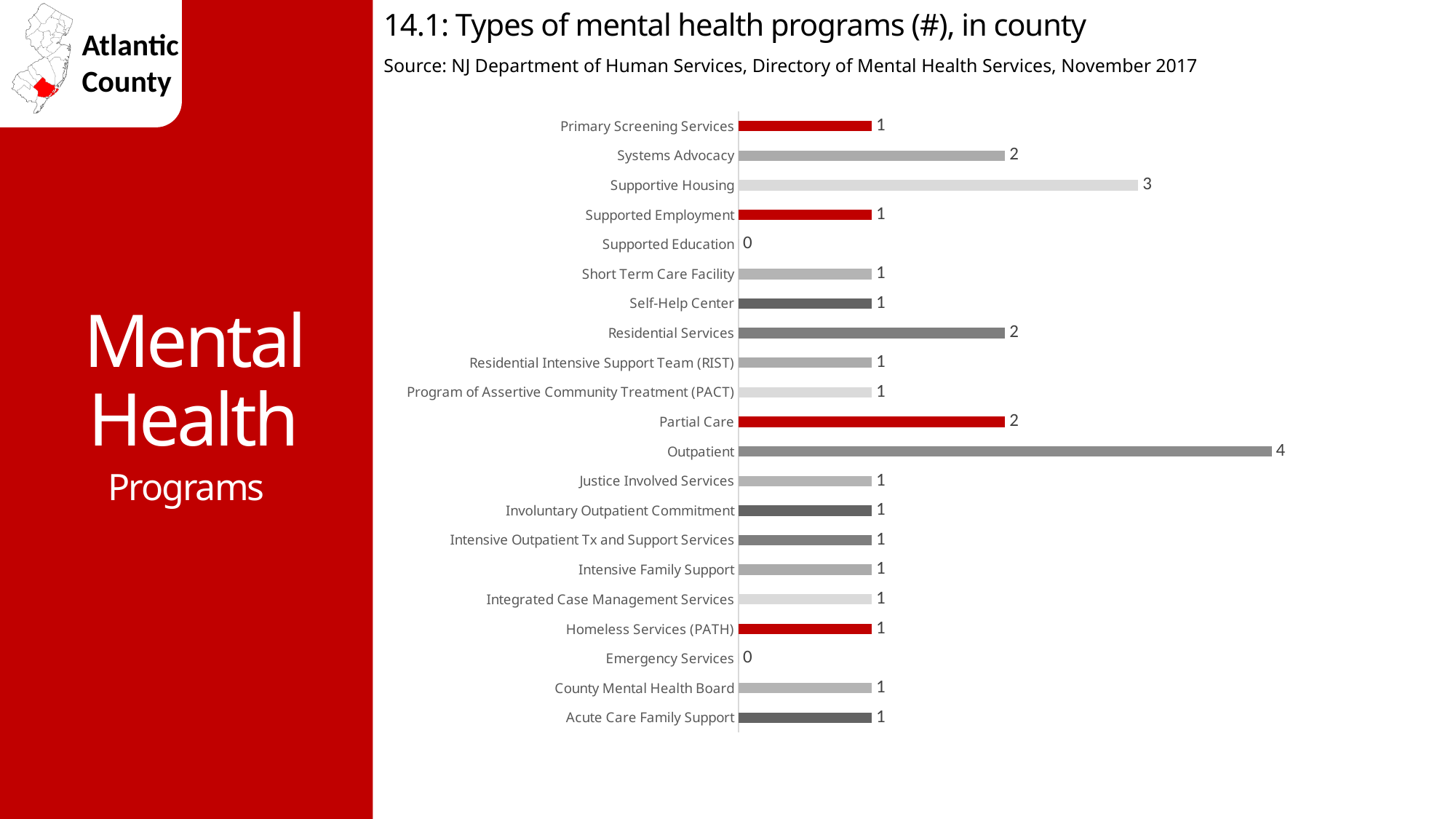
What is the value for Supportive Housing? 3 Which two categories have a value of 0? Supported Education and Emergency Services Which is larger, the value for Systems Advocacy or the value for Primary Screening Services? Systems Advocacy How many program types does the Outpatient category have? 4 Which category has the highest number of programs? Outpatient What is the value for Partial Care? 2 What type of chart is shown on the slide? Bar chart What is the source cited for the chart data? NJ Department of Human Services, Directory of Mental Health Services, November 2017 What is the difference between the values for Outpatient and Supportive Housing? 1 What is the value for Emergency Services? 0 What is the title of the chart? 14.1: Types of mental health programs (#), in county How many categories are shown in the chart? 21